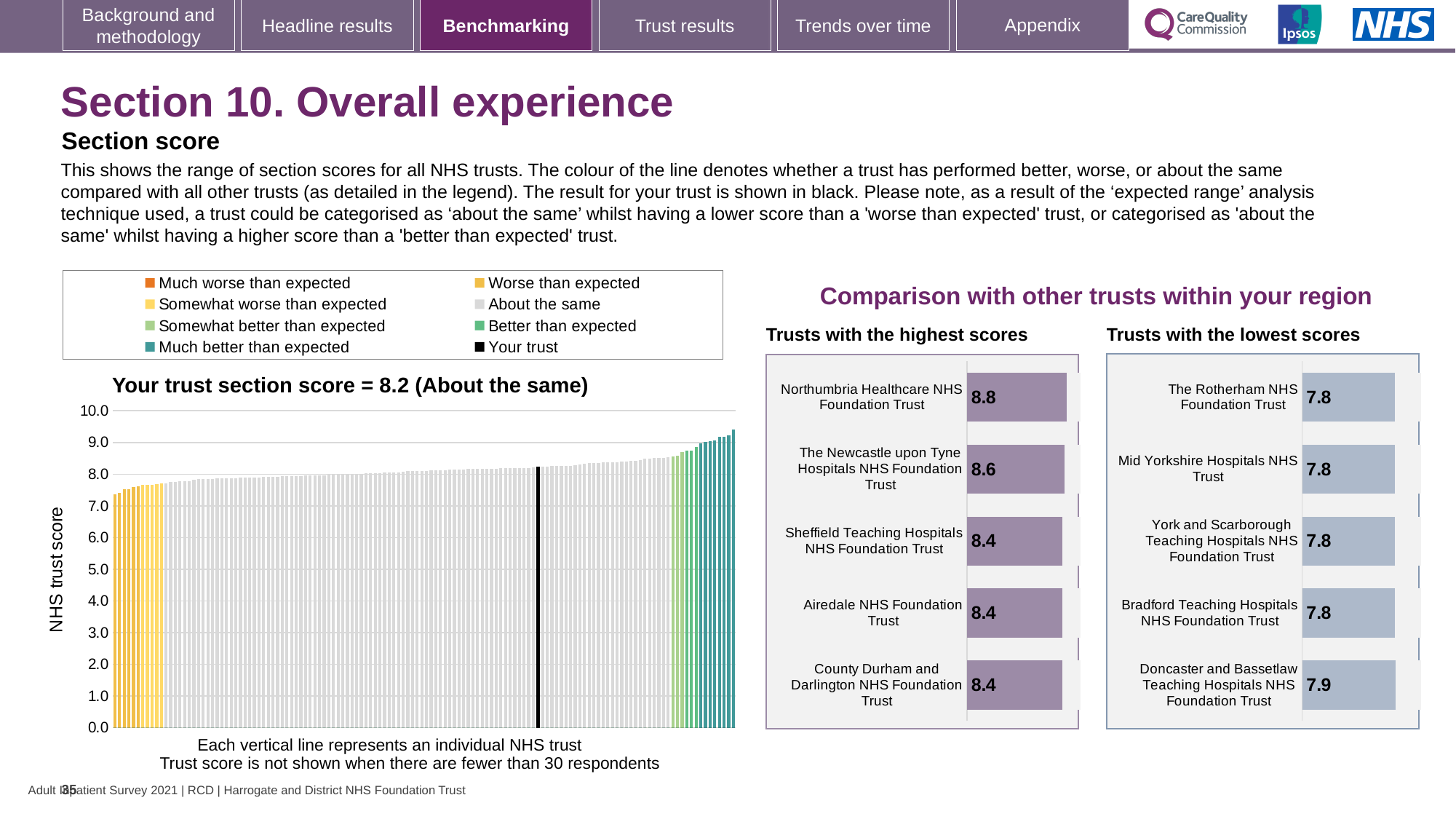
In the 'Your trust section score' chart, do the trust scores rise or fall from left to right along the x axis? rise What kind of chart is the 'Your trust section score' chart? bar chart How many entries does the legend above the 'Your trust section score' chart list? 8 In the 'Trusts with the lowest scores' chart, which trust has the highest score? Doncaster and Bassetlaw Teaching Hospitals NHS Foundation Trust What is the y-axis label of the 'Your trust section score' chart? NHS trust score In the 'Your trust section score' chart, is the value for the rightmost (highest) trust greater or less than 9.0? greater In the 'Trusts with the highest scores' chart, what is the difference between the scores of Northumbria Healthcare NHS Foundation Trust and The Newcastle upon Tyne Hospitals NHS Foundation Trust? 0.2 In the 'Your trust section score' chart, what is the section score for your trust? 8.2 In the 'Your trust section score' chart, is the value for the leftmost (lowest) trust greater or less than 8.0? less In the 'Trusts with the highest scores' chart, what is the score for Northumbria Healthcare NHS Foundation Trust? 8.8 In the 'Your trust section score' chart, what category is your trust placed in? About the same How many trusts are shown in the 'Trusts with the lowest scores' chart? 5